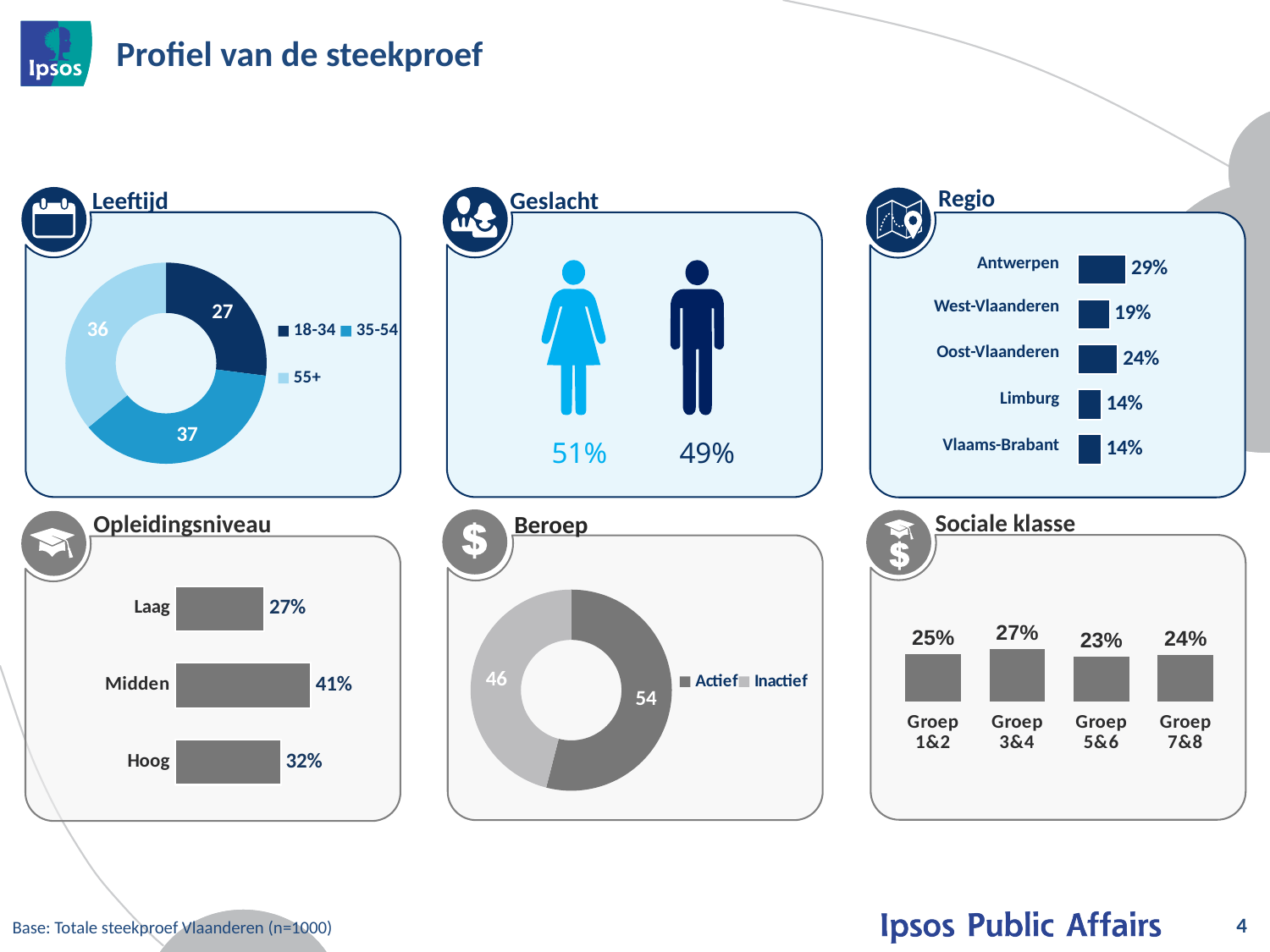
In the Sociale klasse chart, is the value for Groep 5&6 larger or smaller than the value for Groep 7&8? Smaller In the Regio chart, which region has the highest value? Antwerpen In the Beroep chart, what is the value for Actief? 54 In the Leeftijd chart, which age category has the largest share? 35-54 How many regions are shown in the Regio chart? 5 In the Regio chart, what is the difference between Oost-Vlaanderen and West-Vlaanderen? 5% What kind of chart is the Leeftijd chart? Donut chart In the Sociale klasse chart, which group has the highest value? Groep 3&4 In the Regio chart, what is the value for Antwerpen? 29% In the Opleidingsniveau chart, which category has the lowest value? Laag In the Leeftijd chart, what is the value for the 35-54 category? 37 In the Opleidingsniveau chart, what is the value for Midden? 41%